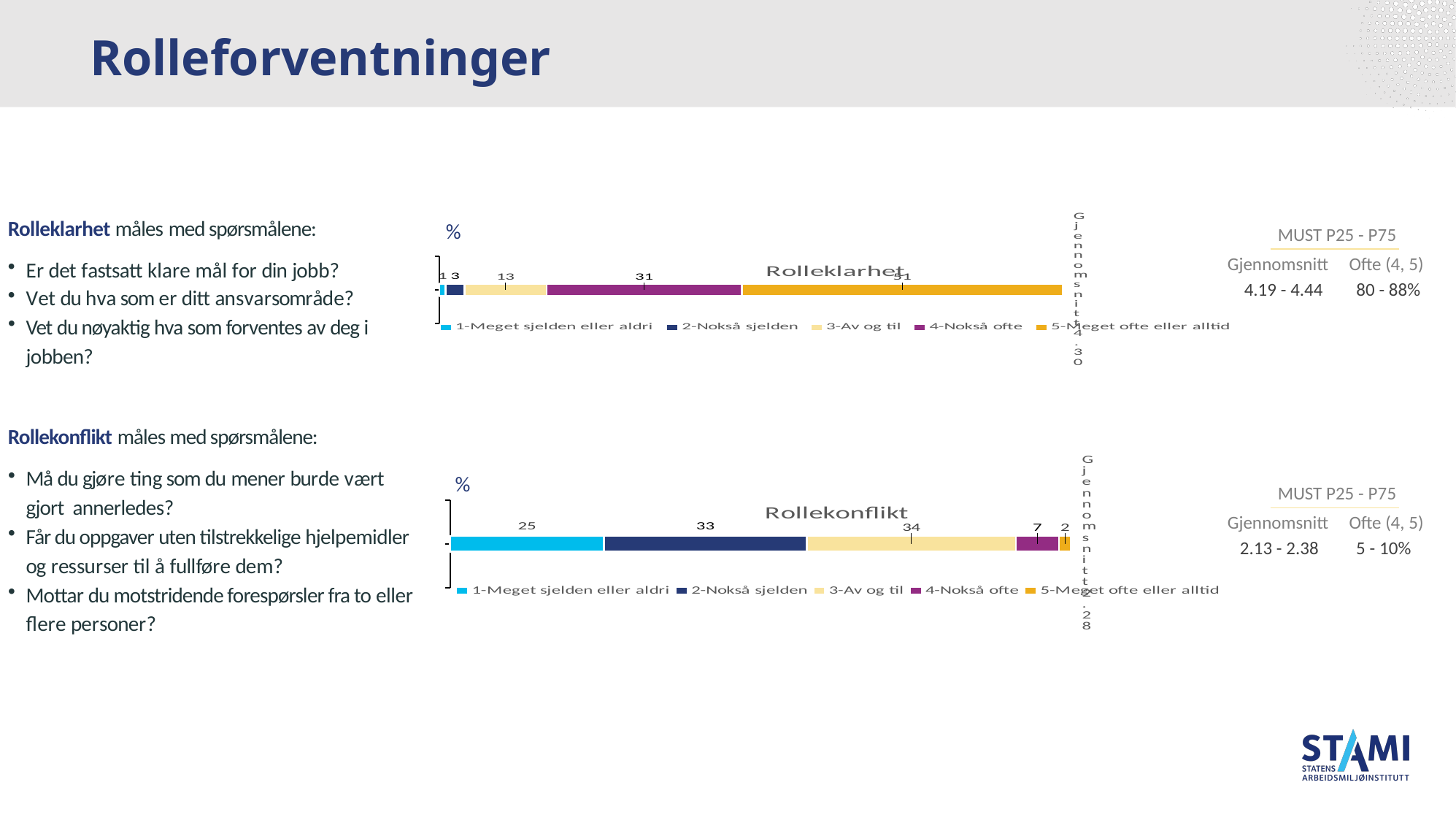
In the Rollekonflikt chart, which response category has the lowest value? 5-Meget ofte eller alltid In the Rollekonflikt chart, what is the value for 1-Meget sjelden eller aldri? 25 In the Rolleklarhet chart, what is the value for 3-Av og til? 13 What kind of chart is the Rollekonflikt chart? Stacked bar chart In the Rollekonflikt chart, what is the total of all segments in the stacked bar? 101 In the Rollekonflikt chart, what is the difference between the values for 2-Nokså sjelden and 4-Nokså ofte? 26 What Gjennomsnitt (average) value is shown next to the Rolleklarhet chart? 4.30 In the Rollekonflikt chart, what is the value for 3-Av og til? 34 In the Rolleklarhet chart, what is the value for 4-Nokså ofte? 31 In the Rollekonflikt chart, which is larger: the value for 1-Meget sjelden eller aldri or the value for 4-Nokså ofte? 1-Meget sjelden eller aldri In the Rolleklarhet chart, which response category has the highest value? 5-Meget ofte eller alltid How many series does the legend of the Rolleklarhet chart list? 5